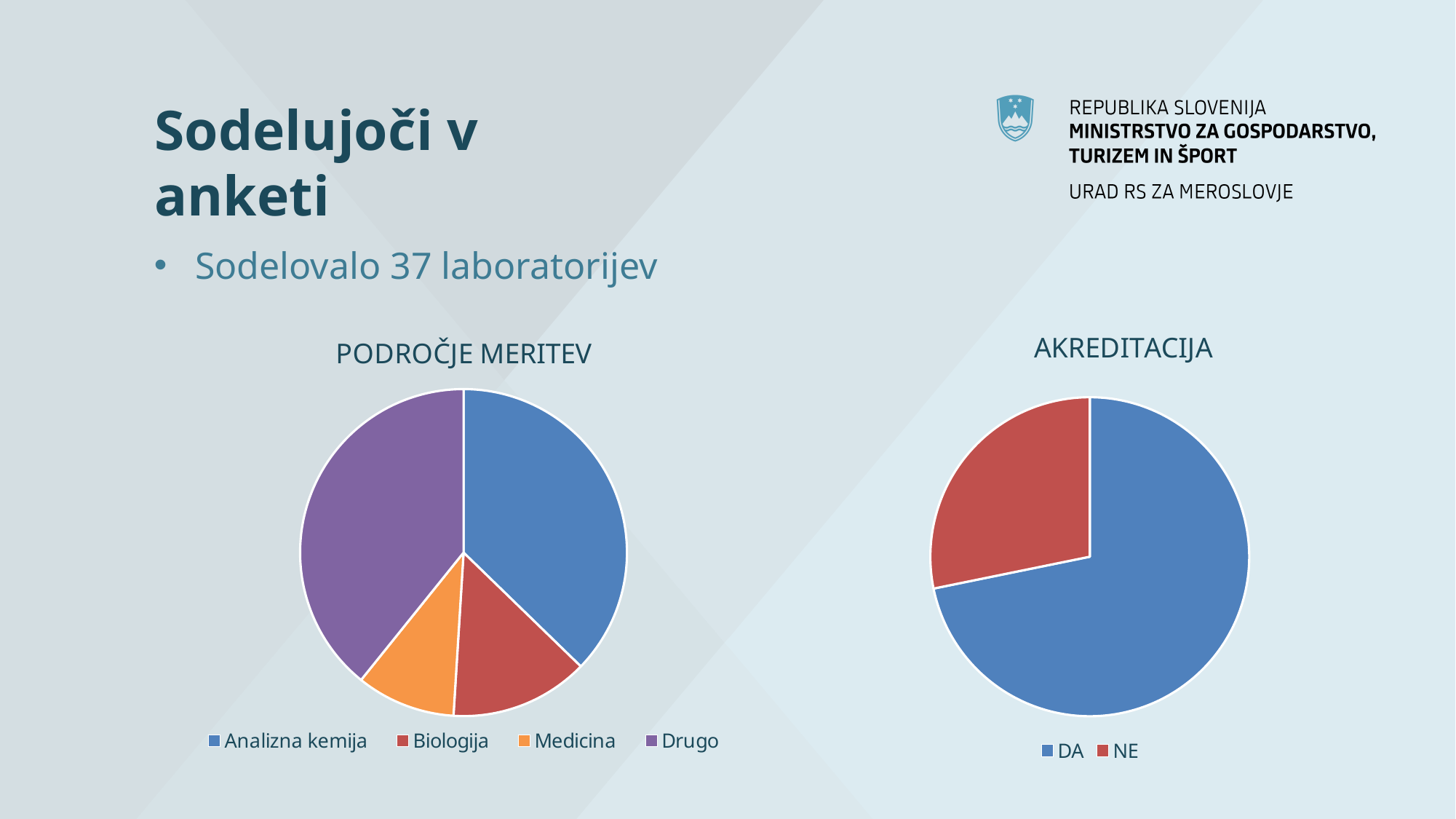
In the PODROČJE MERITEV chart, which slice is larger: Analizna kemija or Biologija? Analizna kemija What kind of chart is the chart titled PODROČJE MERITEV? pie chart In the AKREDITACIJA chart, which category has the largest slice? DA In the AKREDITACIJA chart, which slice is larger: DA or NE? DA What is the title of the pie chart on the right side of the slide? AKREDITACIJA In the PODROČJE MERITEV chart, which slice is larger: Drugo or Medicina? Drugo What kind of chart is the chart titled AKREDITACIJA? pie chart In the AKREDITACIJA chart, how many slices does the pie have? 2 In the AKREDITACIJA chart, which category has the smallest slice? NE In the PODROČJE MERITEV chart, how many categories does the legend list? 4 In the PODROČJE MERITEV chart, what colour is the Medicina slice? orange In the PODROČJE MERITEV chart, which category has the smallest slice? Medicina